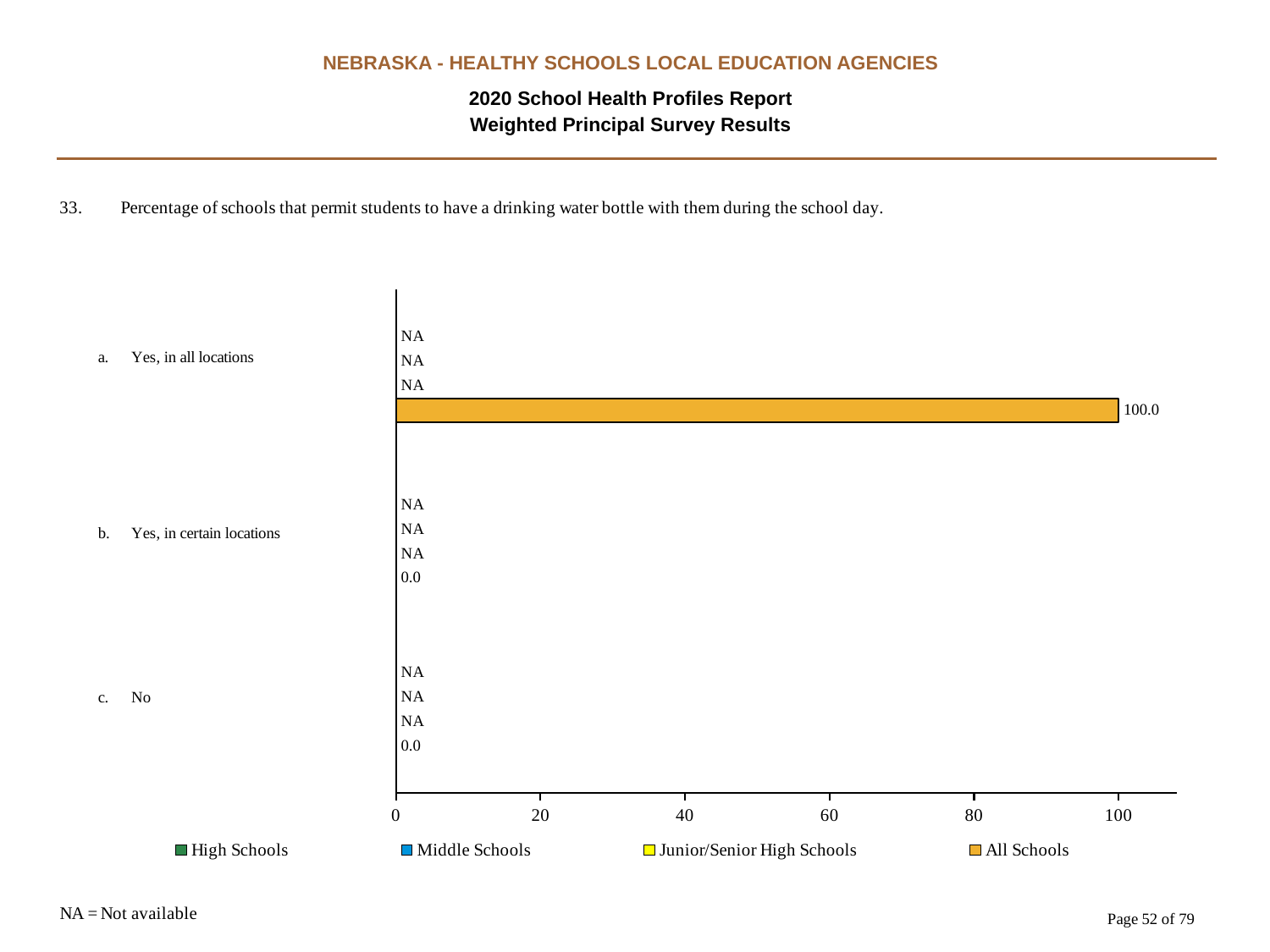
How many categories are shown on the chart? 3 What is the difference between the All Schools values for 'Yes, in all locations' and 'No'? 100.0 What is the value for All Schools in the 'No' category? 0.0 What is the value for All Schools in the 'Yes, in all locations' category? 100.0 What does NA stand for according to the note on the slide? Not available How many series does the legend list? 4 What kind of chart is shown on the slide? Bar chart What is the value for All Schools in the 'Yes, in certain locations' category? 0.0 Which is larger for All Schools: 'Yes, in all locations' or 'Yes, in certain locations'? Yes, in all locations Which category has the highest value for All Schools? Yes, in all locations What is shown for High Schools in the 'Yes, in all locations' category? NA What is shown for Middle Schools in the 'No' category? NA